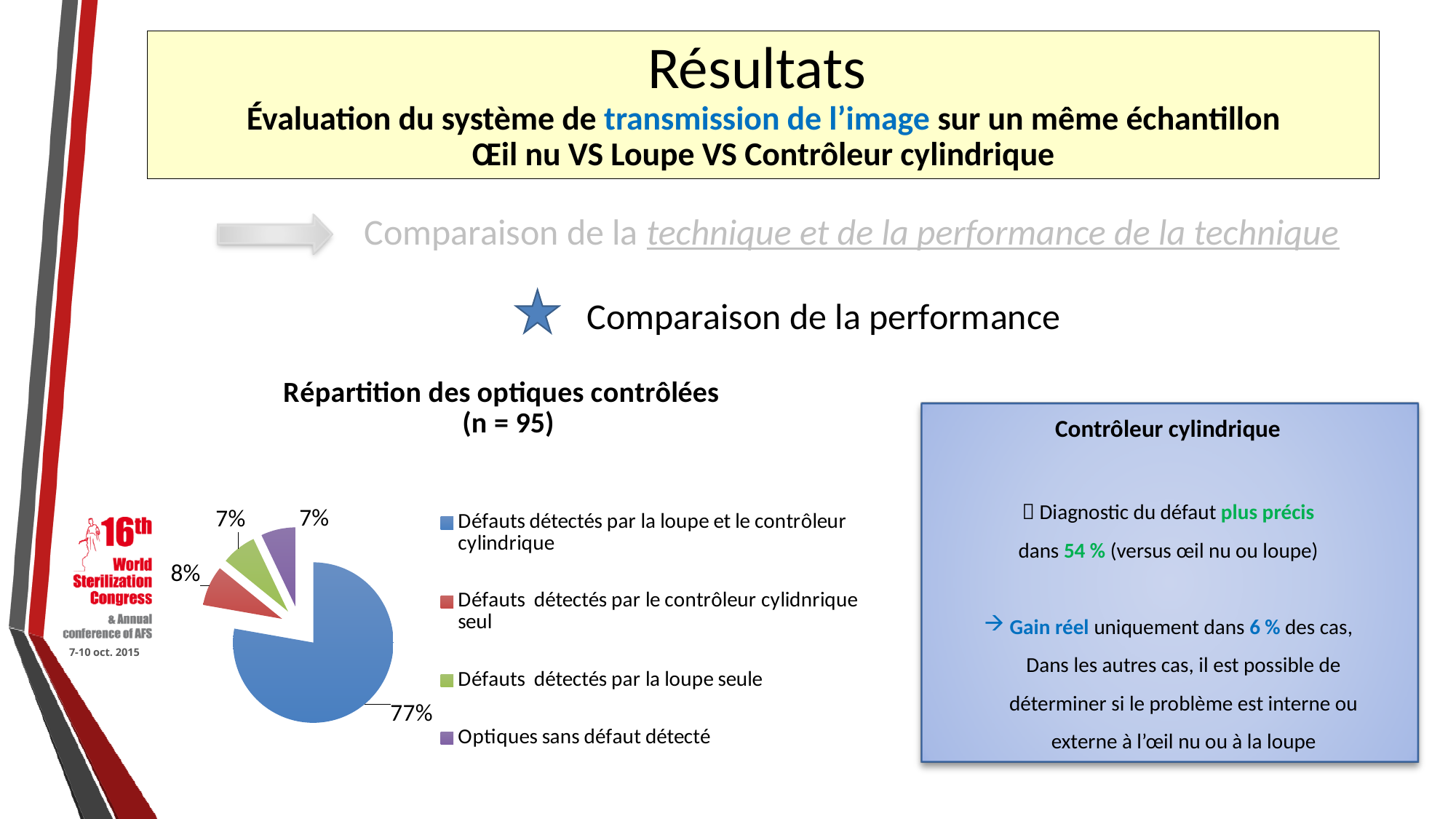
How many entries does the legend of the pie chart list? 4 What kind of chart is shown under the title "Répartition des optiques contrôlées"? Pie chart What colour is the slice for "Optiques sans défaut détecté"? Purple Which is larger: the slice for "Défauts détectés par le contrôleur cylindrique seul" or the slice for "Défauts détectés par la loupe seule"? Défauts détectés par le contrôleur cylindrique seul What is the difference in percentage points between the slice for "Défauts détectés par la loupe et le contrôleur cylindrique" and the slice for "Défauts détectés par le contrôleur cylindrique seul"? 69 percentage points What share of the pie is labelled "Défauts détectés par la loupe et le contrôleur cylindrique"? 77% What share of the pie is labelled "Défauts détectés par la loupe seule"? 7% What sample size (n) is given in the pie chart's title? n = 95 What share of the pie is labelled "Optiques sans défaut détecté"? 7% How many slices does the pie chart have? 4 Which category has the largest slice of the pie? Défauts détectés par la loupe et le contrôleur cylindrique What share of the pie is labelled "Défauts détectés par le contrôleur cylindrique seul"? 8%